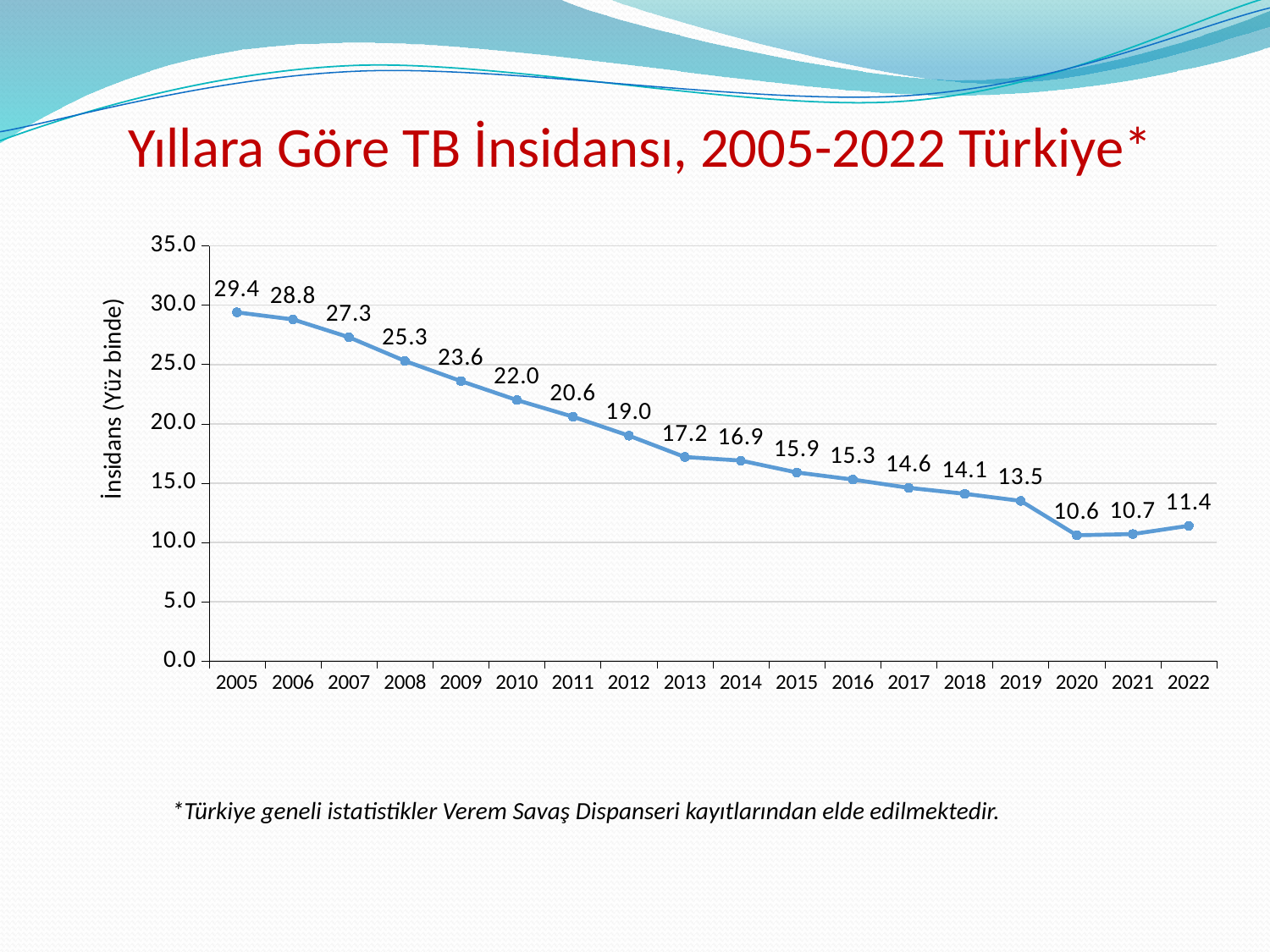
Is the TB incidence value for 2008 greater or less than 25.0? greater What is the difference between the TB incidence in 2005 and in 2022? 18.0 Which year has a higher TB incidence, 2010 or 2015? 2010 What is the label of the vertical axis? İnsidans (Yüz binde) Which year has the highest TB incidence? 2005 What is the TB incidence value for 2022? 11.4 Does the TB incidence generally rise or fall from 2005 to 2020? Fall What is the TB incidence value for 2005? 29.4 What kind of chart is shown on the slide? Line chart How many years are plotted on the chart? 18 What is the TB incidence value for 2013? 17.2 Which year has the lowest TB incidence? 2020